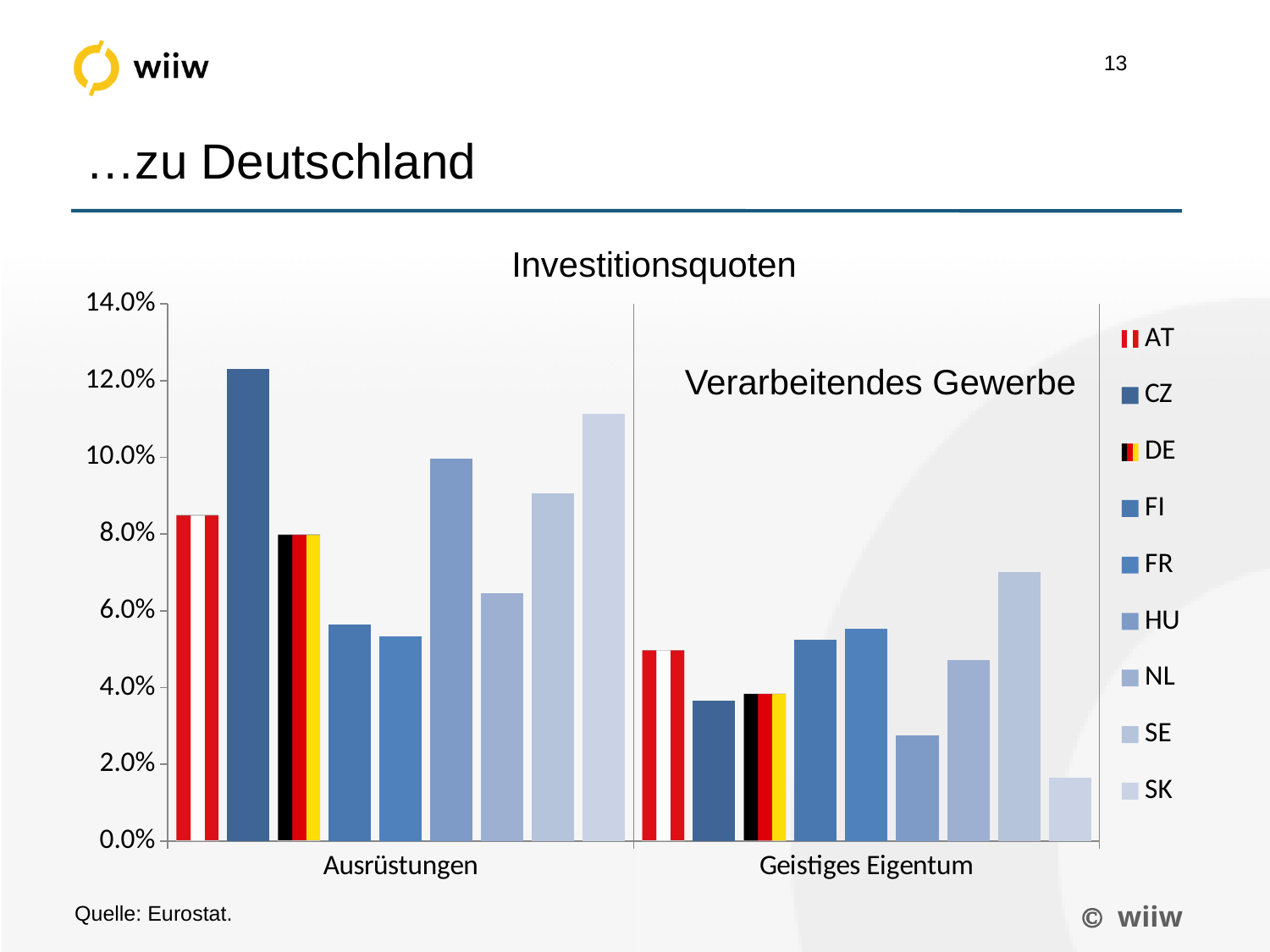
Which country has the highest value in the Geistiges Eigentum category? SE In the Geistiges Eigentum category, which is larger: the value for SE or the value for NL? SE What kind of chart is shown on the slide? bar chart What is the title of the chart? Investitionsquoten What source is cited below the chart? Eurostat How many categories are shown on the x axis? 2 Is the value for CZ in the Ausrüstungen category greater or less than 10.0%? greater How many series does the legend list? 9 Which country has the lowest value in the Geistiges Eigentum category? SK Is the value for SK in the Ausrüstungen category greater or less than 10.0%? greater Which country has the highest value in the Ausrüstungen category? CZ Is the value for HU in the Geistiges Eigentum category greater or less than 4.0%? less